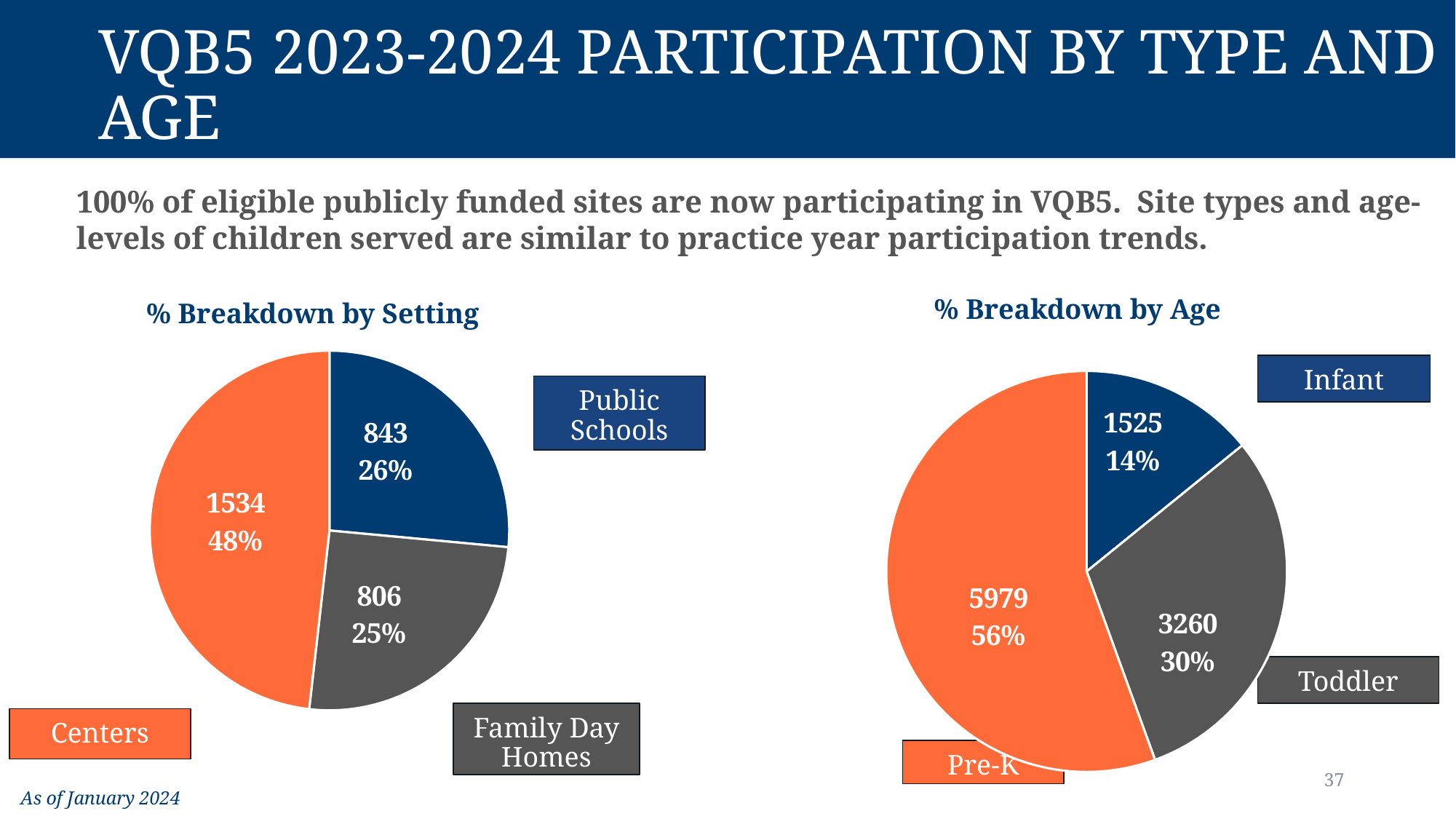
What type of chart is the '% Breakdown by Age' chart? Pie chart In the '% Breakdown by Setting' chart, how many categories are shown? 3 In the '% Breakdown by Age' chart, what percentage share does Pre-K have? 56% In the '% Breakdown by Setting' chart, what is the count for Centers? 1534 In the '% Breakdown by Setting' chart, which setting has the smallest slice? Family Day Homes In the '% Breakdown by Setting' chart, what percentage share do Public Schools have? 26% In the '% Breakdown by Age' chart, what is the count for Toddler? 3260 In the '% Breakdown by Age' chart, which age group has the smallest slice? Infant In the '% Breakdown by Setting' chart, what is the difference between the Centers count and the Public Schools count? 691 In the '% Breakdown by Age' chart, what is the difference between the Pre-K count and the Toddler count? 2719 In the '% Breakdown by Age' chart, which is larger, the Toddler count or the Infant count? Toddler In the '% Breakdown by Setting' chart, which setting has the largest slice? Centers